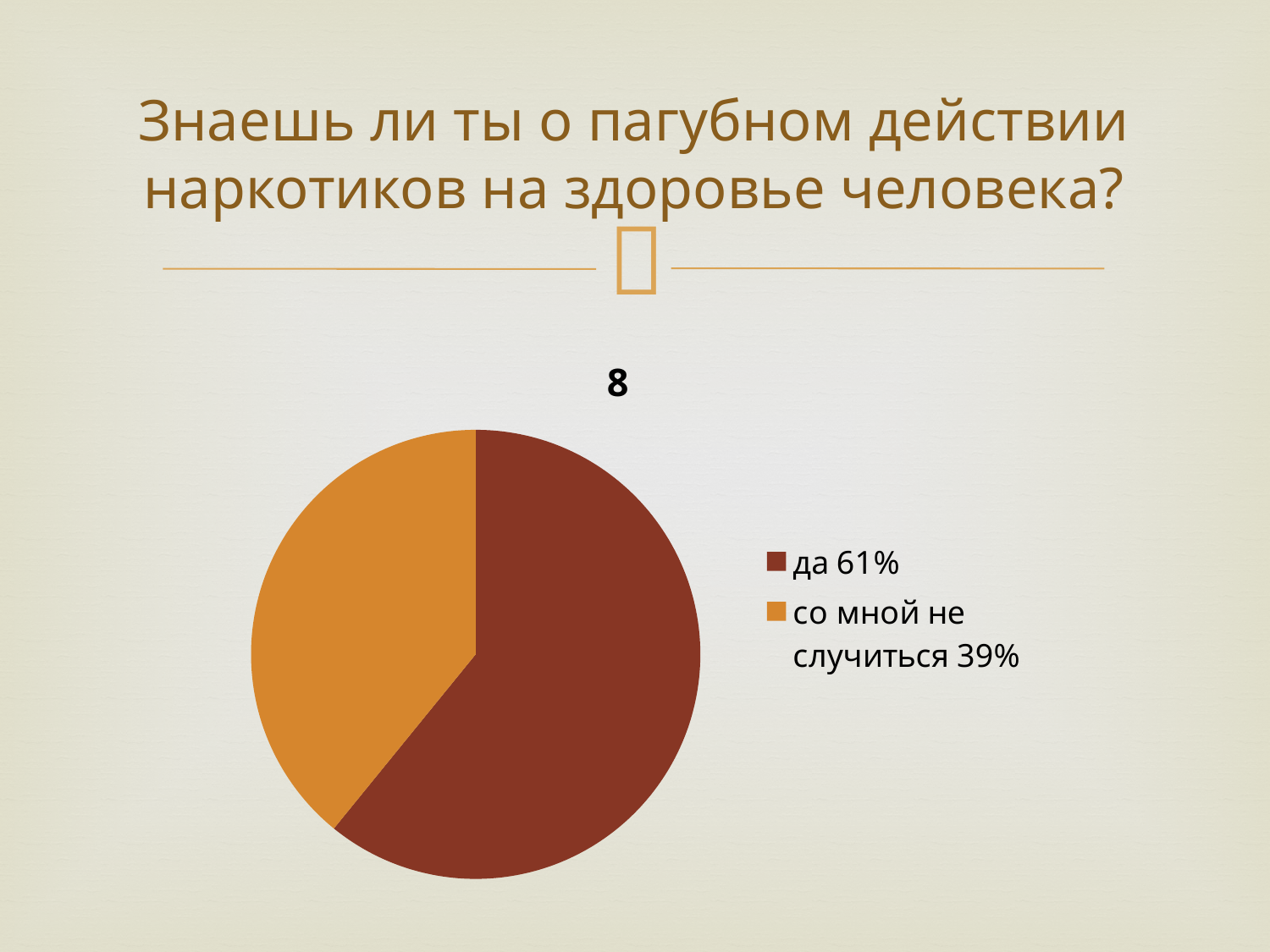
What is the difference in percentage points between the 'да' slice and the 'со мной не случиться' slice? 22 How many entries does the legend of the pie chart list? 2 Which is larger: the 'да' slice or the 'со мной не случиться' slice? да What share of the pie does the 'да' slice represent? 61% How many slices does the pie chart have? 2 What percentage is shown in the legend for the 'со мной не случиться' slice? 39% What percentage is shown in the legend for the 'да' slice? 61% What is the chart title shown above the pie chart? 8 What colour is the 'со мной не случиться 39%' slice in the pie chart? orange Which slice of the pie chart is the largest? да 61% What kind of chart is shown on the slide? pie chart Which slice of the pie chart is the smallest? со мной не случиться 39%